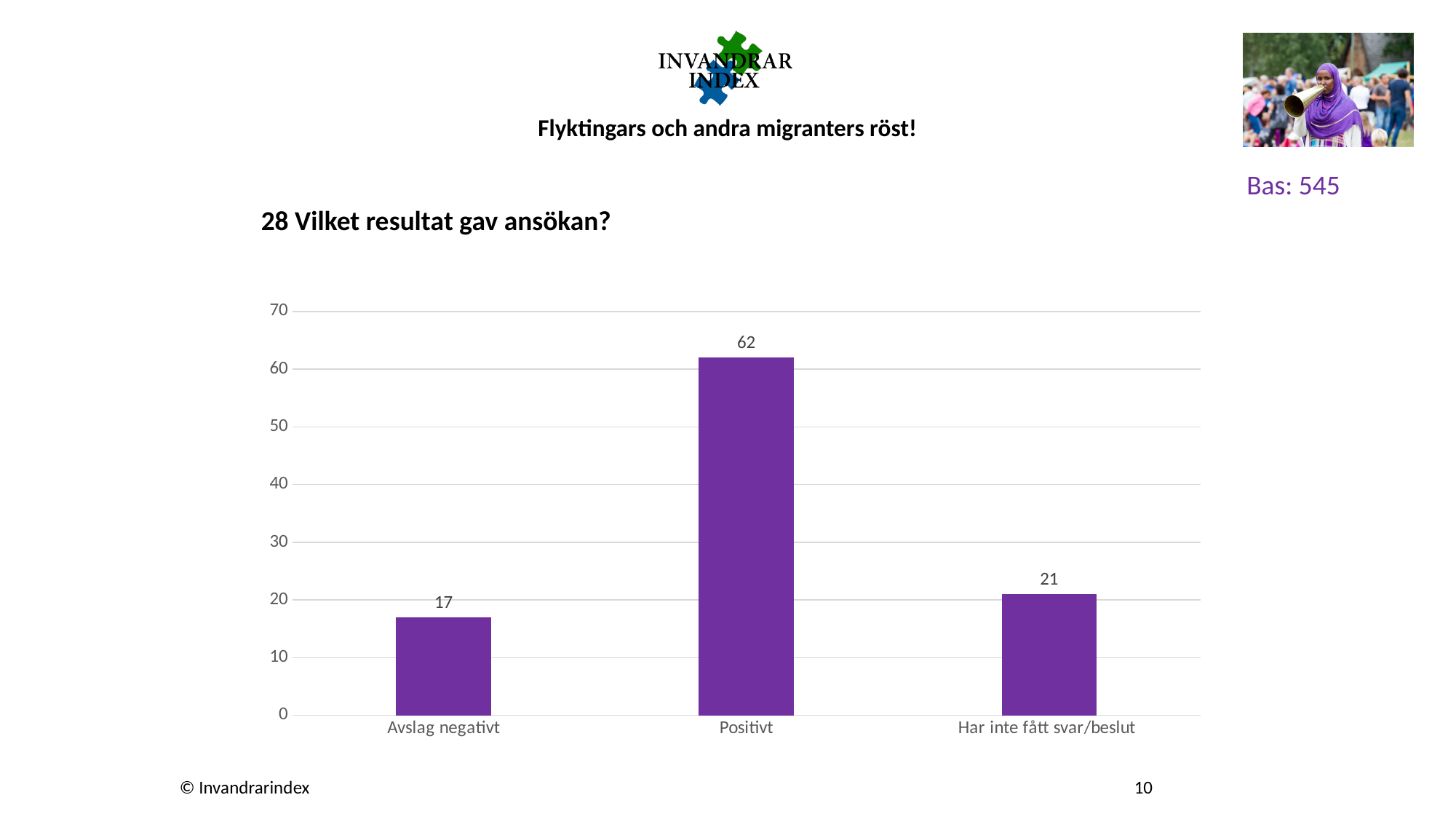
How many categories are shown on the x axis? 3 Which category has the highest value? Positivt What is the value for Har inte fått svar/beslut? 21 What is the value for Avslag negativt? 17 What is the difference between the values for Positivt and Avslag negativt? 45 What kind of chart is shown on the slide? bar chart Is the value for Positivt greater or less than 50? greater What is the difference between the values for Har inte fått svar/beslut and Avslag negativt? 4 Which category has the lowest value? Avslag negativt Which is larger, the value for Har inte fått svar/beslut or the value for Avslag negativt? Har inte fått svar/beslut What is the title of the chart? 28 Vilket resultat gav ansökan? What is the value for Positivt? 62